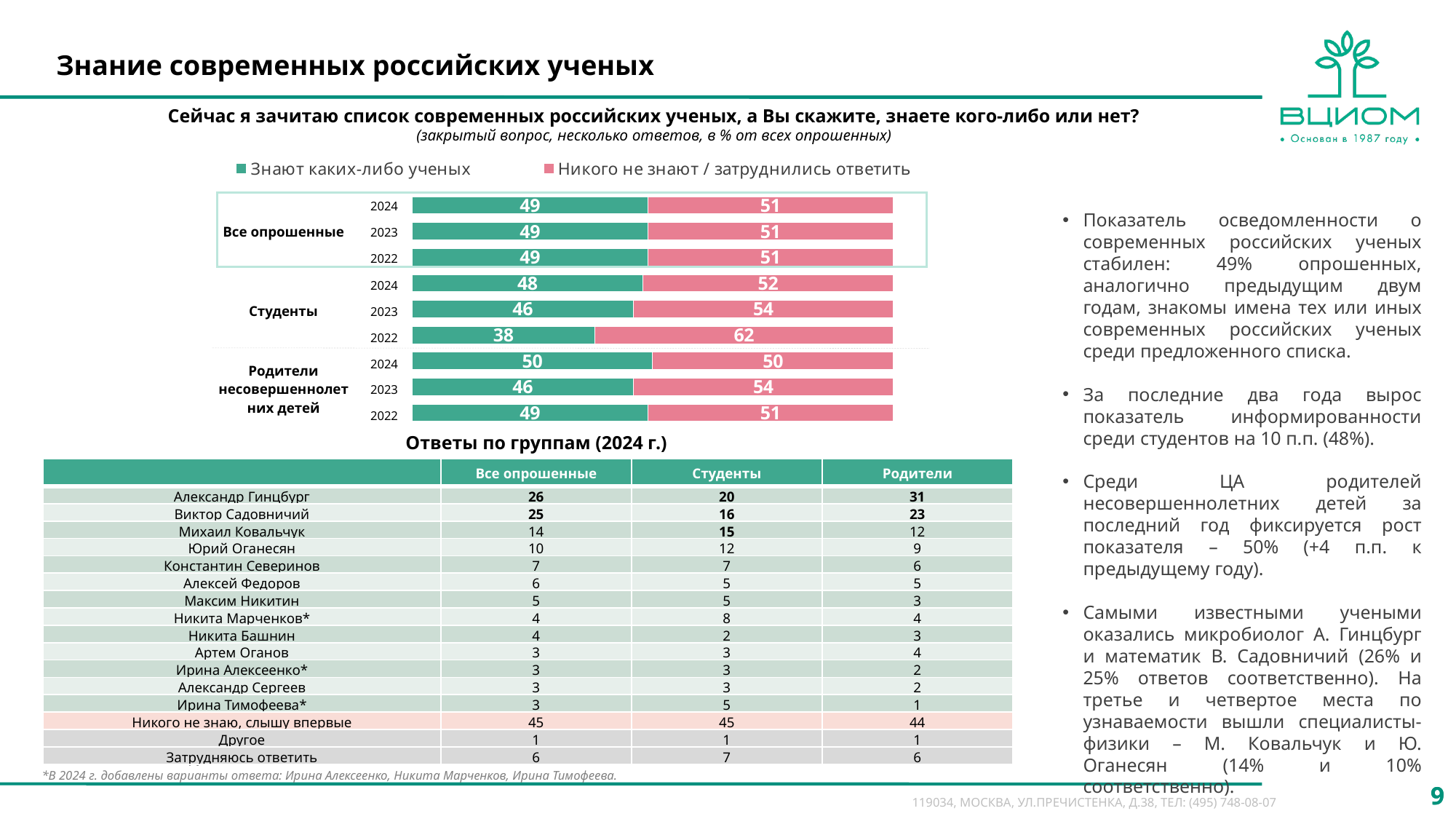
How many series does the chart legend list? 2 Which group and year has the highest value for 'Никого не знают / затруднились ответить'? Студенты, 2022 Which group and year has the lowest value for 'Знают каких-либо ученых'? Студенты, 2022 What is the value of 'Знают каких-либо ученых' for Студенты in 2022? 38 What is the legend label of the green series? Знают каких-либо ученых What is the value of 'Никого не знают / затруднились ответить' for Студенты in 2024? 52 What type of chart is shown on the slide? stacked bar chart What is the difference between the 'Знают каких-либо ученых' values for Студенты in 2024 and 2022? 10 How many bars are plotted in the chart? 9 What is the total of the stacked bar for Родители несовершеннолетних детей in 2023? 100 What is the value of 'Знают каких-либо ученых' for Родители несовершеннолетних детей in 2024? 50 Which is larger: the 'Знают каких-либо ученых' value for Студенты in 2023 or for Все опрошенные in 2023? Все опрошенные in 2023